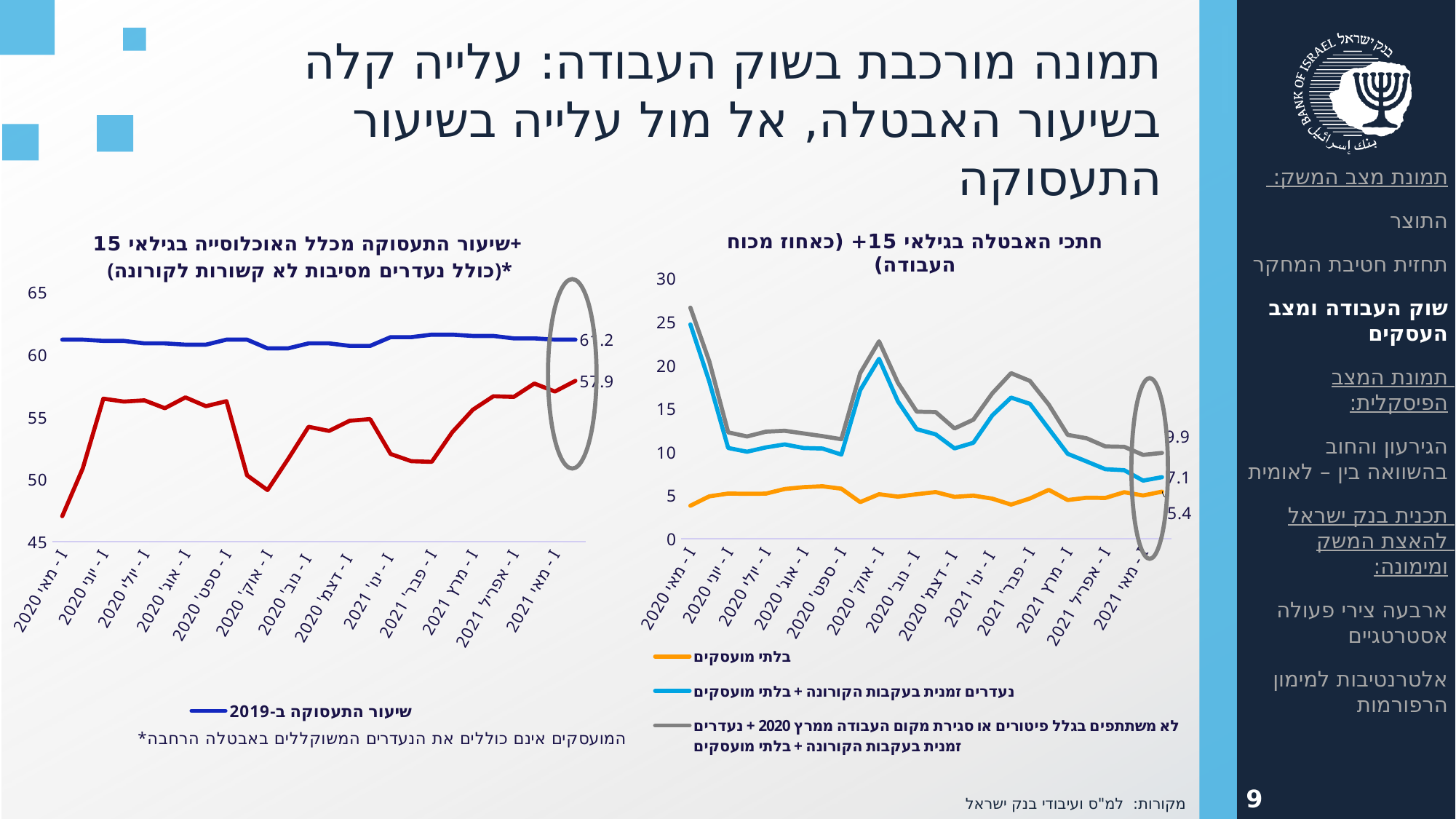
In the left chart (שיעור התעסוקה), what value is labelled for the blue line (שיעור התעסוקה ב-2019) at מאי 2021? 61.2 What type of chart is the right chart (חתכי האבטלה בגילאי 15+)? Line chart In the right chart (חתכי האבטלה בגילאי 15+), is the value of the gray line at אוק' 2020 greater or less than 20? greater In the left chart (שיעור התעסוקה), what is the difference between the labelled values of the blue line and the red line at מאי 2021? 3.3 In the right chart (חתכי האבטלה בגילאי 15+), which series has the highest value at מאי 2021? לא משתתפים בגלל פיטורים או סגירת מקום העבודה ממרץ 2020 + נעדרים זמנית בעקבות הקורונה + בלתי מועסקים How many time points are shown on the x axis of the left chart (שיעור התעסוקה)? 13 In the left chart (שיעור התעסוקה), what value is labelled for the red line at מאי 2021? 57.9 In the right chart (חתכי האבטלה בגילאי 15+), what value is labelled for the light-blue line at מאי 2021? 7.1 How many series does the legend of the right chart (חתכי האבטלה בגילאי 15+) list? 3 In the right chart (חתכי האבטלה בגילאי 15+), what is the difference between the labelled values of the gray line and the orange line at מאי 2021? 4.5 In the right chart (חתכי האבטלה בגילאי 15+), what value is labelled for the gray line at מאי 2021? 9.9 In the right chart (חתכי האבטלה בגילאי 15+), what value is labelled for the orange line (בלתי מועסקים) at מאי 2021? 5.4